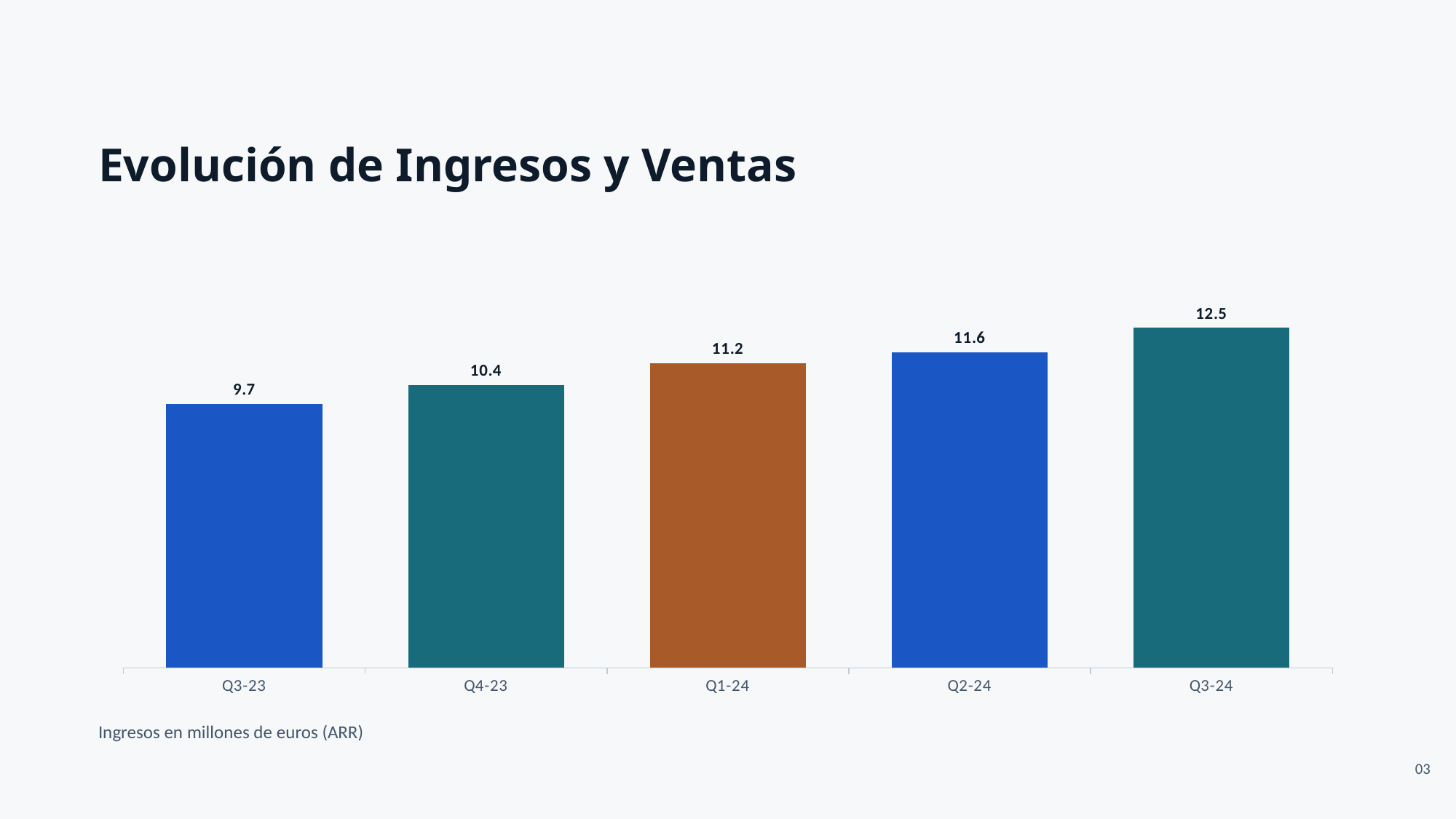
What is the value for Q3-23? 9.7 Do the values rise or fall from Q3-23 to Q3-24? Rise What is the value for Q1-24? 11.2 What kind of chart is shown on the slide? Bar chart Which quarter has the lowest value? Q3-23 What is the title of the slide? Evolución de Ingresos y Ventas What is the difference between the values for Q2-24 and Q4-23? 1.2 Which quarter has the highest value? Q3-24 Which is larger, the value for Q4-23 or the value for Q2-24? Q2-24 What is the value for Q3-24? 12.5 How many quarters are shown on the x axis? 5 What is the difference between the values for Q3-24 and Q3-23? 2.8